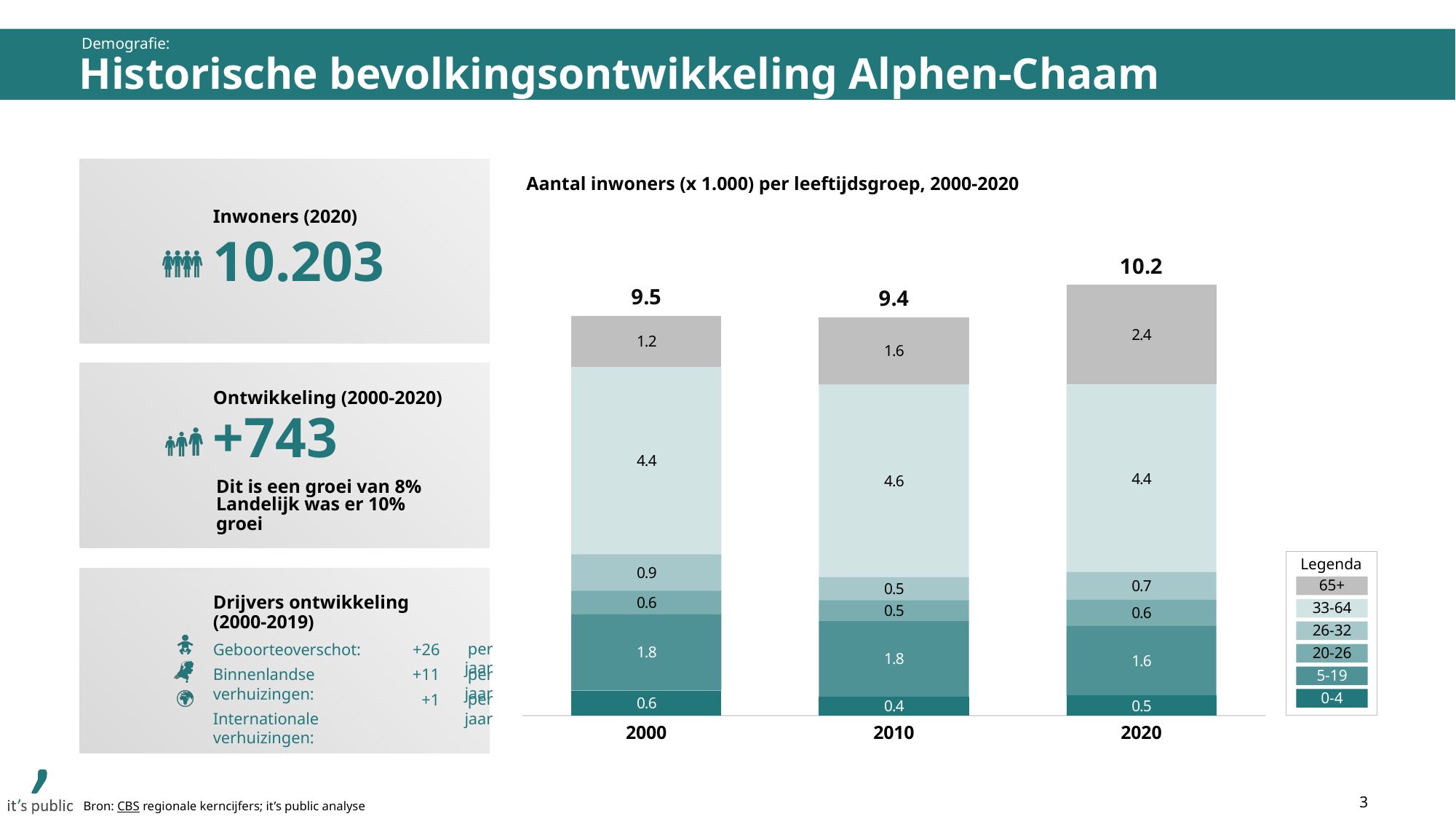
What is the value for the 0-4 age group in 2000? 0.6 What is the total of the stacked bar for 2020? 10.2 What type of chart is shown on the slide? Stacked bar chart What is the value for the 33-64 age group in 2010? 4.6 How many age groups does the legend list? 6 Which year has the highest value for the 65+ age group? 2020 What is the value for the 65+ age group in 2020? 2.4 What is the difference between the 65+ value in 2020 and in 2000? 1.2 Which year has the lowest total number of inhabitants? 2010 How many years are shown on the x axis? 3 Is the 5-19 value larger in 2000 or in 2020? 2000 What is the title of the chart? Aantal inwoners (x 1.000) per leeftijdsgroep, 2000-2020